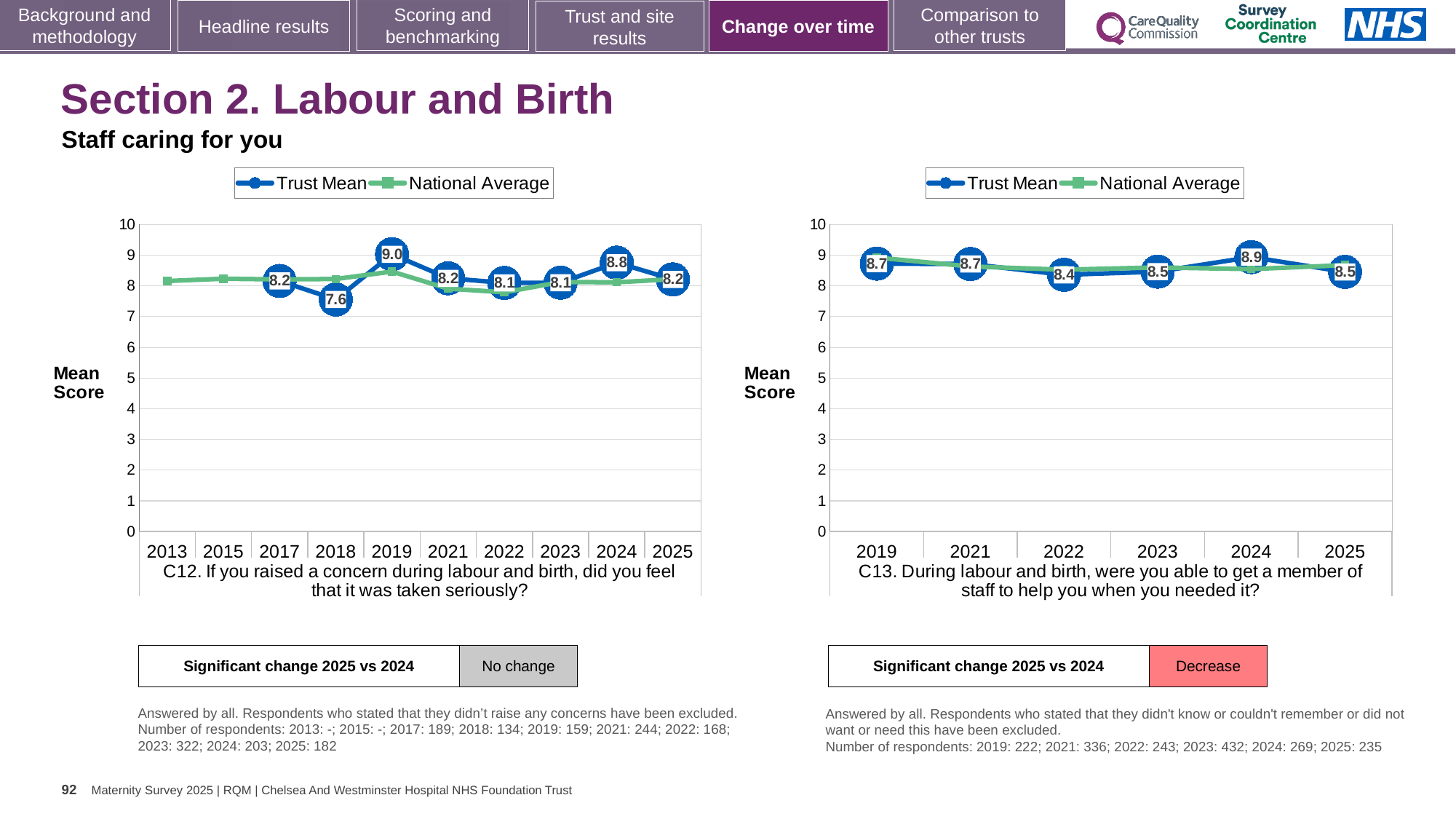
In the C13 chart on the right, which year has the lowest Trust Mean? 2022 In the C13 chart on the right, what is the Trust Mean for 2025? 8.5 In the C12 chart on the left, which year has the lowest Trust Mean? 2018 In the C12 chart on the left, what is the Trust Mean for 2019? 9.0 In the C13 chart on the right, what is the Trust Mean for 2024? 8.9 In the C12 chart on the left, how many years are shown on the x axis? 10 In the C12 chart on the left, what is the difference between the Trust Mean in 2024 and in 2025? 0.6 In the C13 chart on the right, how many series does the legend list? 2 In the C13 chart on the right, is the Trust Mean higher in 2019 or in 2022? 2019 What type of chart is the C13 chart on the right? Line chart In the C12 chart on the left, which year has the highest Trust Mean? 2019 In the C12 chart on the left, what is the Trust Mean for 2018? 7.6